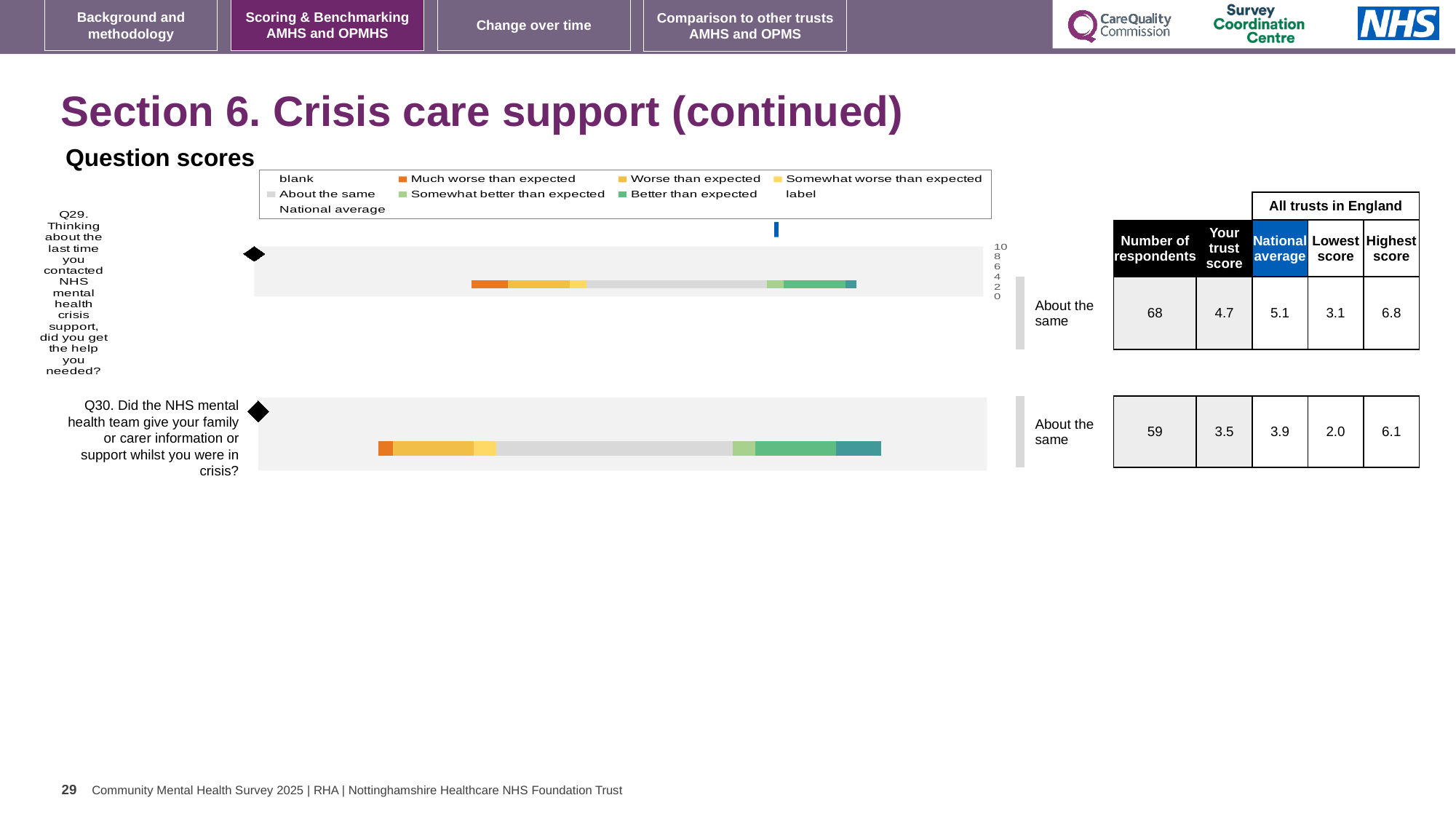
Which legend entry in the question scores chart is shown in grey? About the same Which legend entry in the question scores chart is shown in orange? Much worse than expected What is the trust score for Q29 in the question scores chart? 4.7 What benchmark category is shown next to the Q30 bar in the question scores chart? About the same What kind of chart is used to show the question scores for Q29 and Q30? Bar chart Which question has the higher trust score in the question scores chart, Q29 or Q30? Q29 What benchmark category is shown next to the Q29 bar in the question scores chart? About the same How many respondents answered Q29 in the question scores chart? 68 How many questions (bars) are plotted in the question scores chart? 2 What is the difference between the trust scores for Q29 and Q30 in the question scores chart? 1.2 What is the trust score for Q30 in the question scores chart? 3.5 What is the national average for Q30 in the question scores chart? 3.9